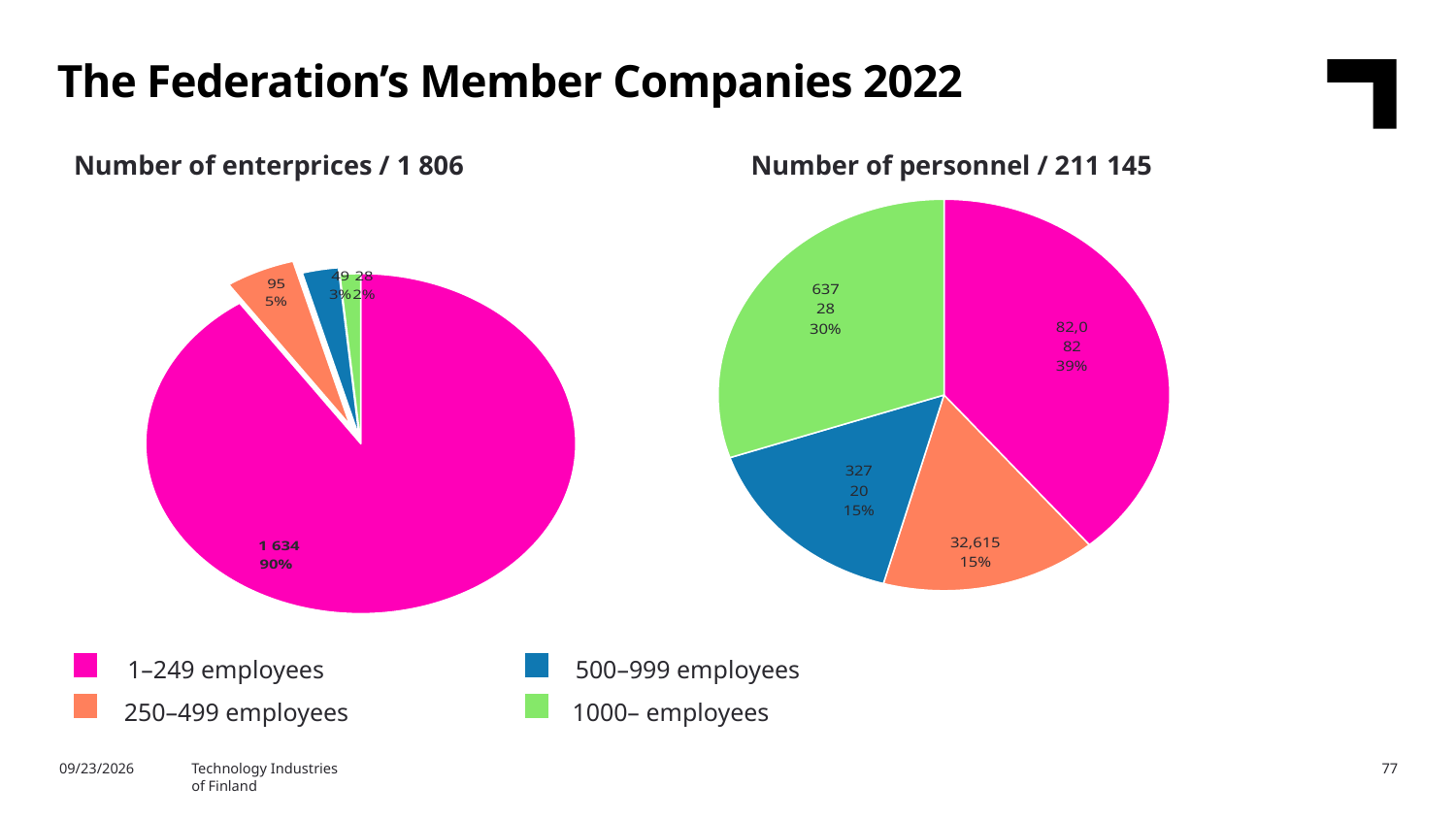
In the 'Number of enterprices' chart, what is the value for 1–249 employees? 1 634 In the 'Number of personnel' chart, what share of the pie is the 1000– employees slice? 30% In the 'Number of enterprices' chart, which category has the largest slice? 1–249 employees In the 'Number of personnel' chart, what is the value for 250–499 employees? 32,615 In the 'Number of enterprices' chart, what is the difference between the values for 250–499 employees and 500–999 employees? 46 In the 'Number of personnel' chart, what share of the pie is the 1–249 employees slice? 39% In the 'Number of personnel' chart, which category has the largest slice? 1–249 employees In the 'Number of enterprices' chart, what share of the pie is the 250–499 employees slice? 5% In the 'Number of personnel' chart, which slice is larger: 1000– employees or 500–999 employees? 1000– employees How many categories does the legend list? 4 What kind of charts are shown on the slide? Pie charts In the 'Number of enterprices' chart, which category has the smallest slice? 1000– employees